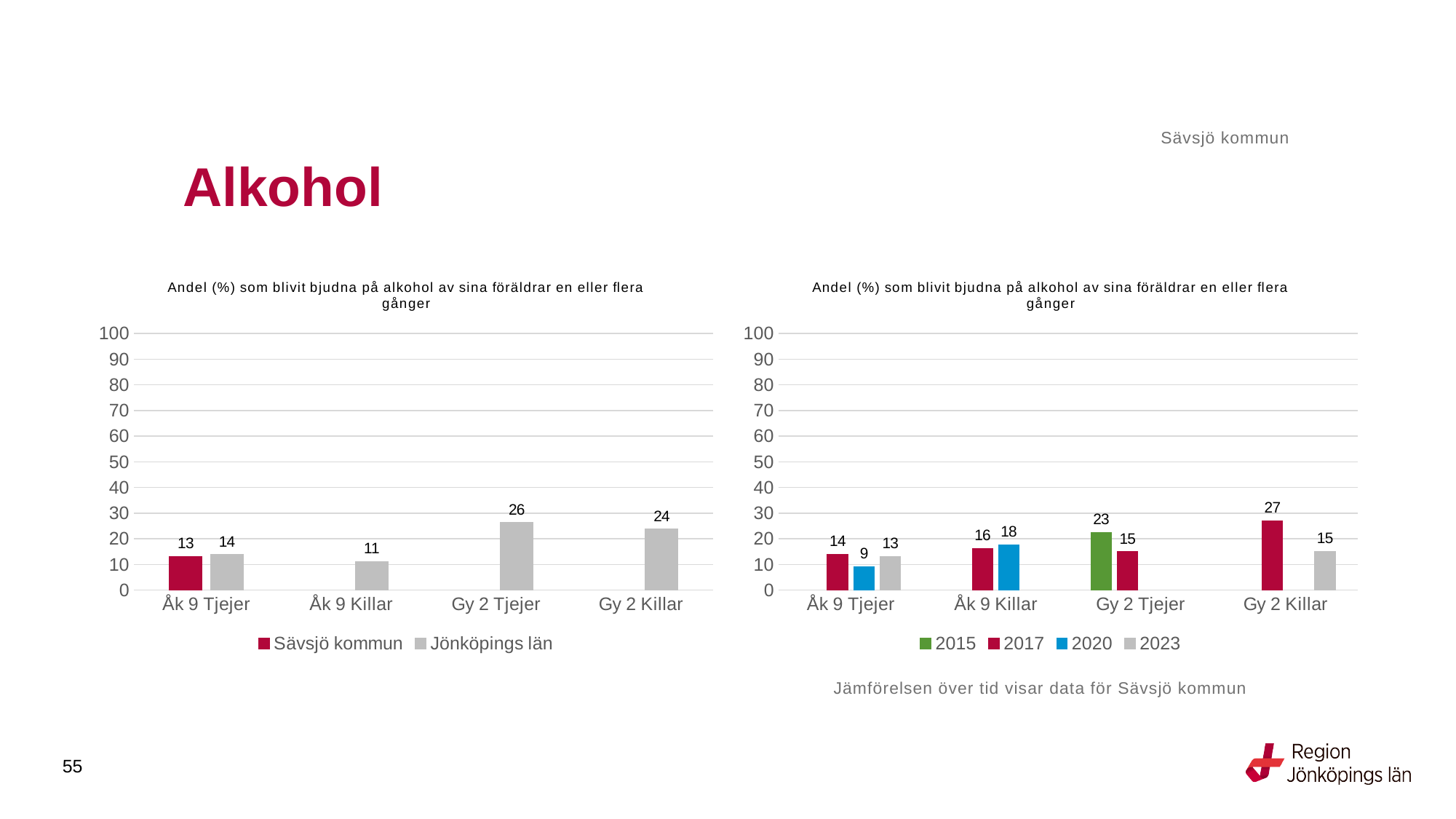
In the left chart, which category has the lowest value for Jönköpings län? Åk 9 Killar In the left chart, what is the value for Sävsjö kommun for Åk 9 Tjejer? 13 In the left chart, what is the value for Jönköpings län for Gy 2 Tjejer? 26 In the right chart, how many series does the legend list? 4 In the right chart, what is the difference between the 2017 and 2023 values for Gy 2 Killar? 12 In the right chart, what is the value for 2015 for Gy 2 Tjejer? 23 In the left chart, how many series does the legend list? 2 In the right chart, what is the value for 2020 for Åk 9 Killar? 18 In the right chart, which is larger for Åk 9 Tjejer: the 2020 value or the 2023 value? 2023 In the left chart, what is the difference between Jönköpings län for Gy 2 Tjejer and Gy 2 Killar? 2 What kind of chart is the right chart? Bar chart In the right chart, which category has the highest value for 2017? Gy 2 Killar